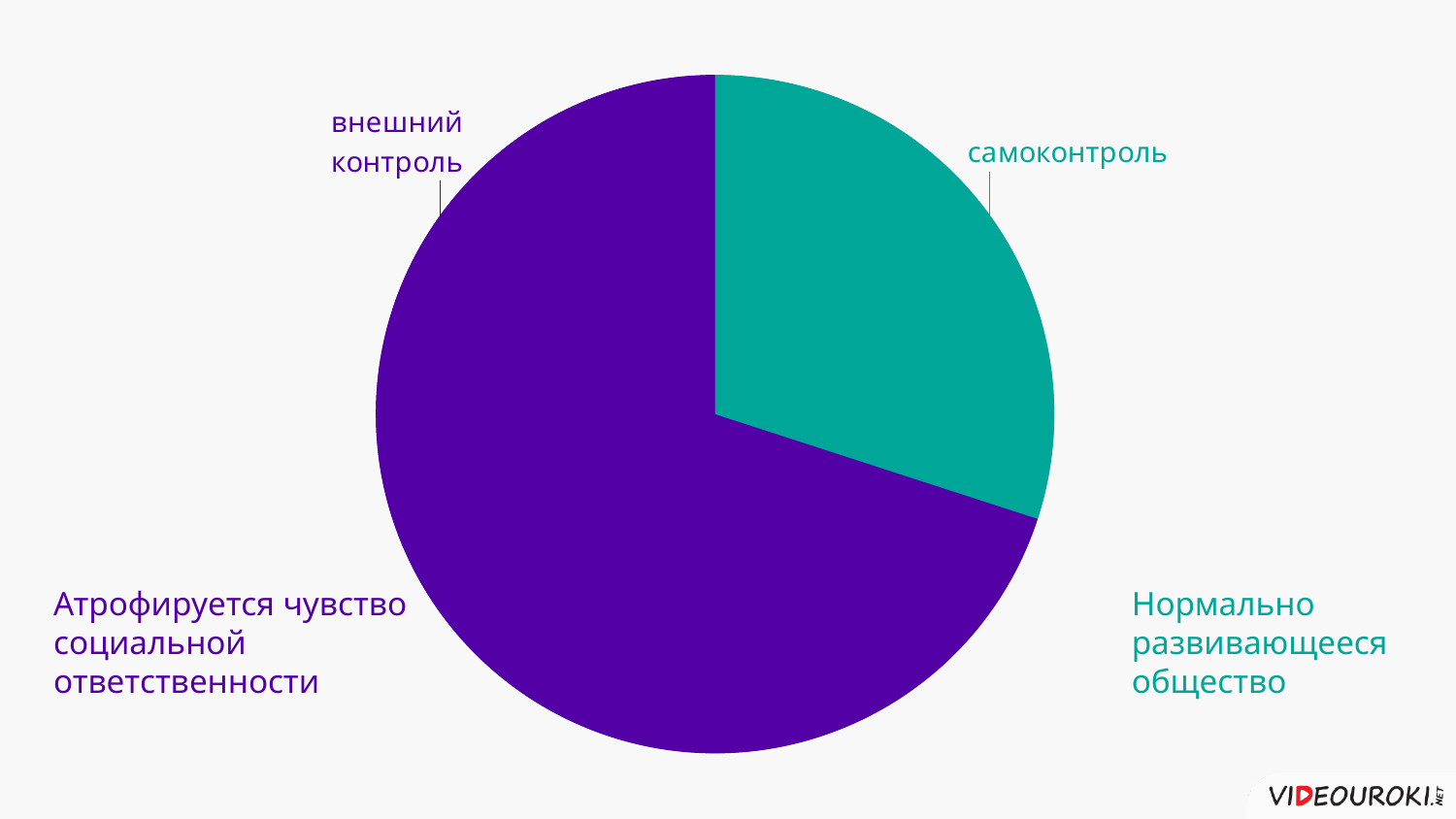
How many slices does the pie chart have? 2 What kind of chart is shown on the slide? pie chart Does the slice for внешний контроль take up more or less than half of the pie? more Does the slice for самоконтроль take up more or less than half of the pie? less Which slice is larger, внешний контроль or самоконтроль? внешний контроль What colour is the slice labelled самоконтроль? teal Which slice of the pie chart is the smallest? самоконтроль Which slice of the pie chart is the largest? внешний контроль What colour is the slice labelled внешний контроль? purple